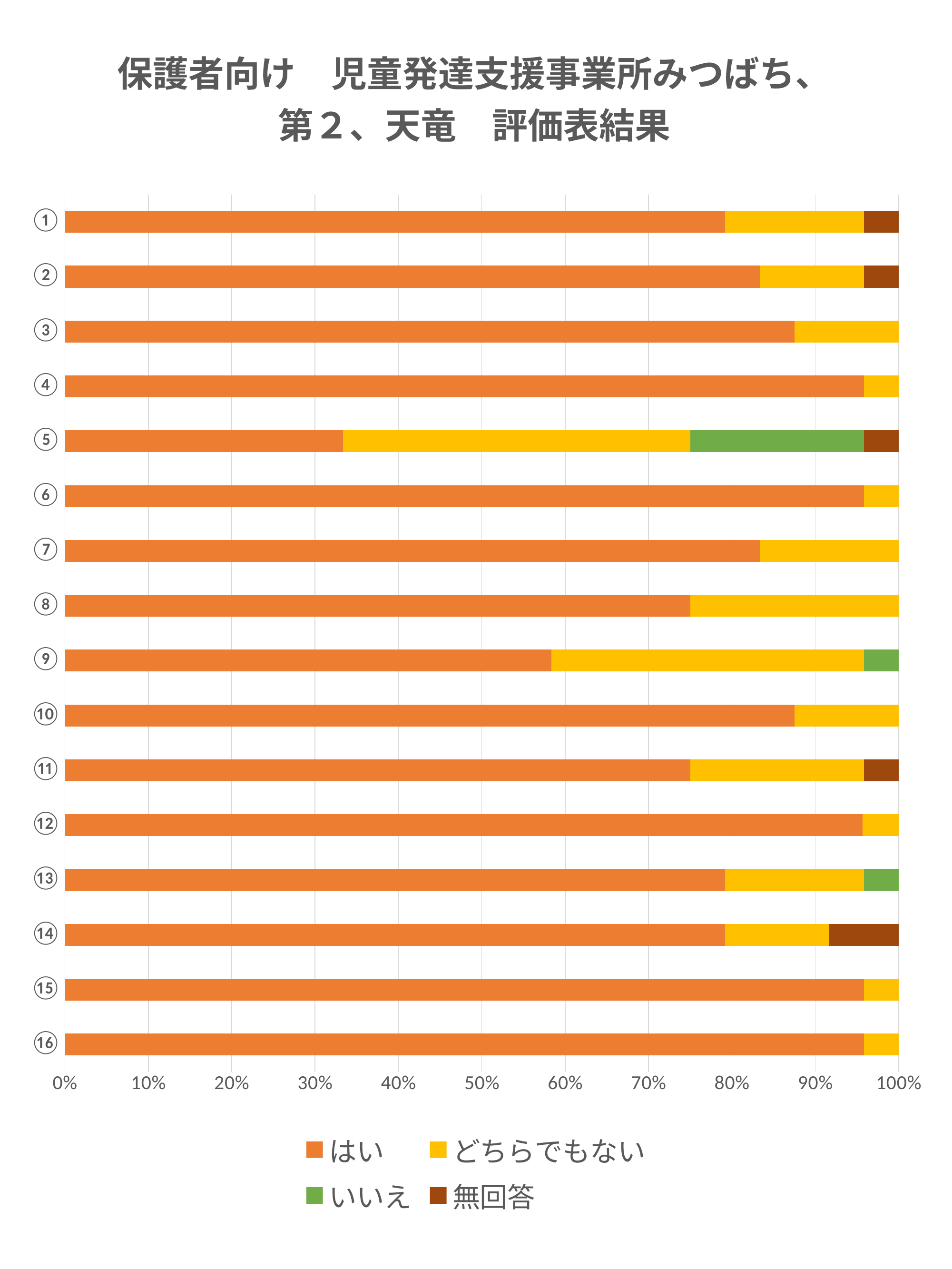
What kind of chart is shown on the slide? Stacked bar chart Which category has a larger はい share, ⑤ or ⑨? ⑨ How many categories (numbered items) are plotted on the chart? 16 How many series does the legend list? 4 Which category has a larger はい share, ③ or ⑧? ③ Which category has the lowest share of はい? ⑤ How many categories include a 無回答 segment? 5 What colour represents いいえ in the legend? Green Is the はい value for ④ greater or less than 90%? greater Is the はい value for ⑨ greater or less than 50%? greater How many categories include an いいえ segment? 3 Is the はい value for ⑤ greater or less than 40%? less